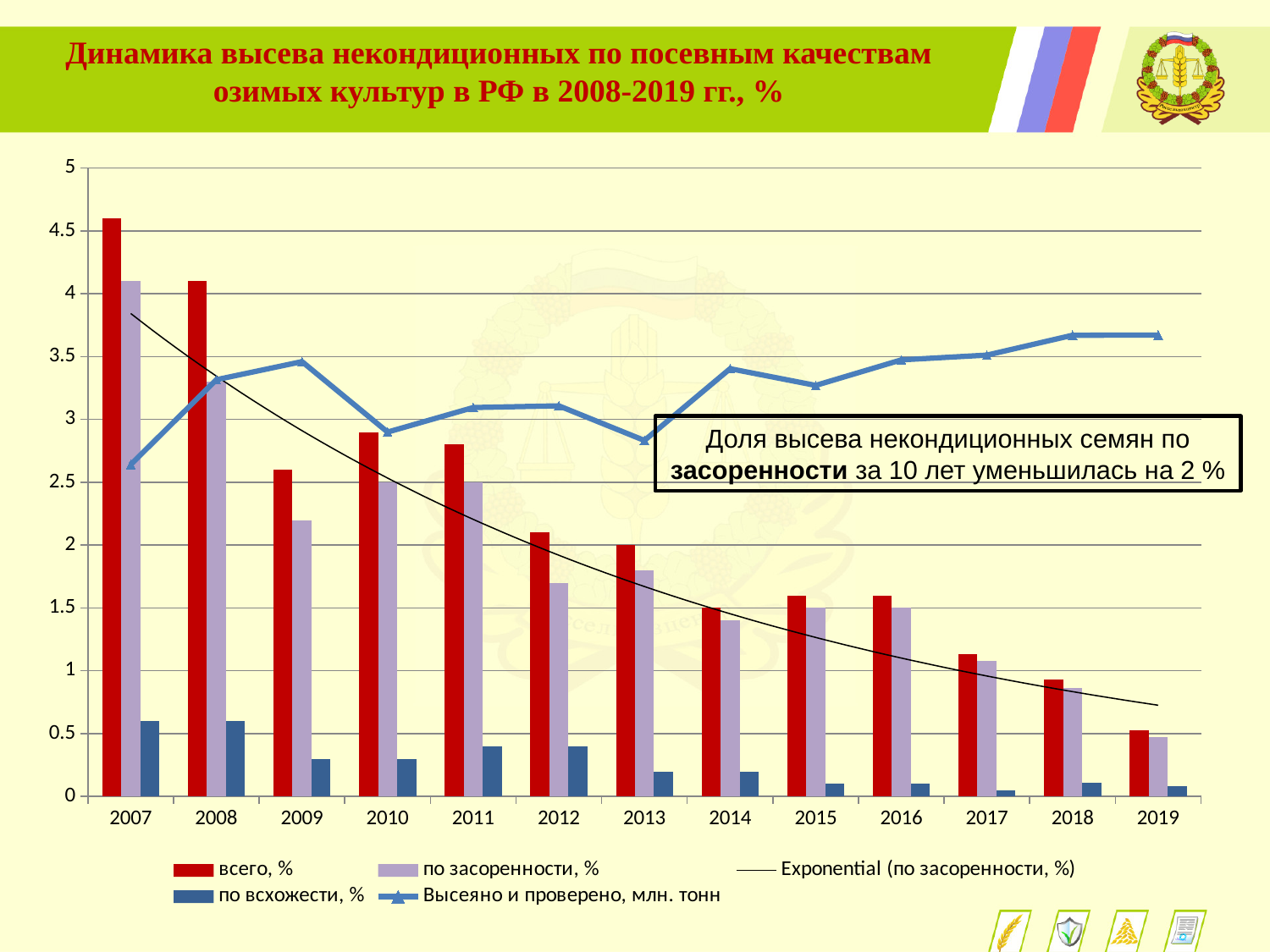
What colour are the bars for the series "по всхожести, %"? Blue Is the value of "всего, %" for 2019 greater or less than 1? less Do the values of the series "всего, %" generally rise or fall from 2007 to 2019? fall In which year is the value of the series "всего, %" lowest? 2019 Which year has the larger value for "по засоренности, %": 2009 or 2010? 2010 In which year is the value of the series "по засоренности, %" highest? 2007 What kind of chart is shown on the slide? Bar chart combined with a line chart How many series does the chart legend list? 5 How many years (categories) are shown on the x axis of the chart? 13 Is the value of "всего, %" for 2007 greater or less than 4? greater In which year is the value of the series "всего, %" highest? 2007 Is the value of "Высеяно и проверено, млн. тонн" for 2019 greater or less than 3.5? greater